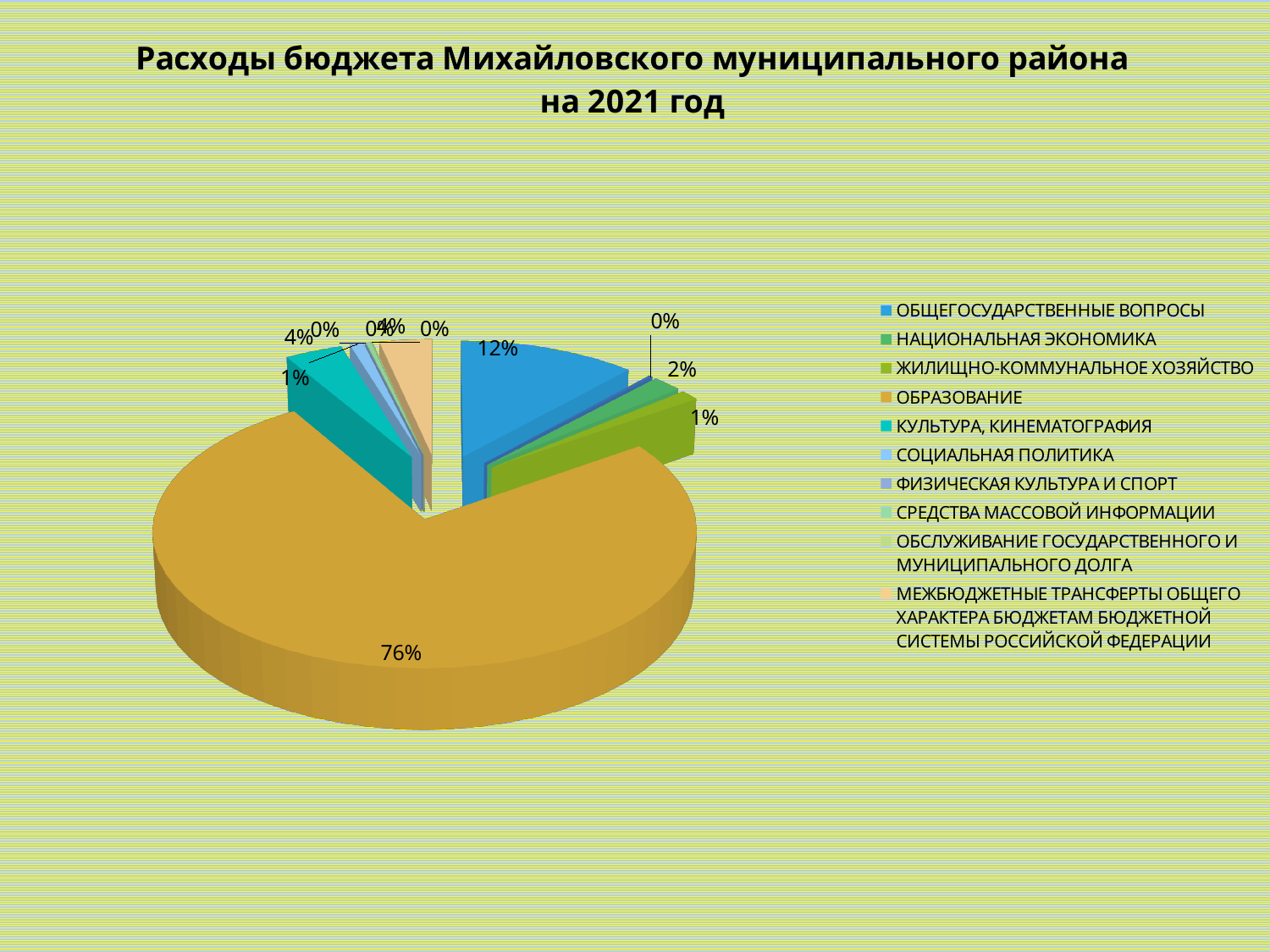
What kind of chart is shown on the slide? pie chart How many categories does the legend list? 10 Which category has the largest slice of the pie? ОБРАЗОВАНИЕ What is the title of the chart? Расходы бюджета Михайловского муниципального района на 2021 год Which is larger, the slice for ОБРАЗОВАНИЕ or the slice for ОБЩЕГОСУДАРСТВЕННЫЕ ВОПРОСЫ? ОБРАЗОВАНИЕ By how many percentage points does ОБРАЗОВАНИЕ exceed ОБЩЕГОСУДАРСТВЕННЫЕ ВОПРОСЫ? 64 percentage points What is the value shown for НАЦИОНАЛЬНАЯ ЭКОНОМИКА? 2% What is the value shown for ОБЩЕГОСУДАРСТВЕННЫЕ ВОПРОСЫ? 12% What is the value shown for ЖИЛИЩНО-КОММУНАЛЬНОЕ ХОЗЯЙСТВО? 1% Which is larger, the slice for НАЦИОНАЛЬНАЯ ЭКОНОМИКА or the slice for ЖИЛИЩНО-КОММУНАЛЬНОЕ ХОЗЯЙСТВО? НАЦИОНАЛЬНАЯ ЭКОНОМИКА What share of the pie does ОБРАЗОВАНИЕ take? 76% What colour is the slice for ОБРАЗОВАНИЕ? orange